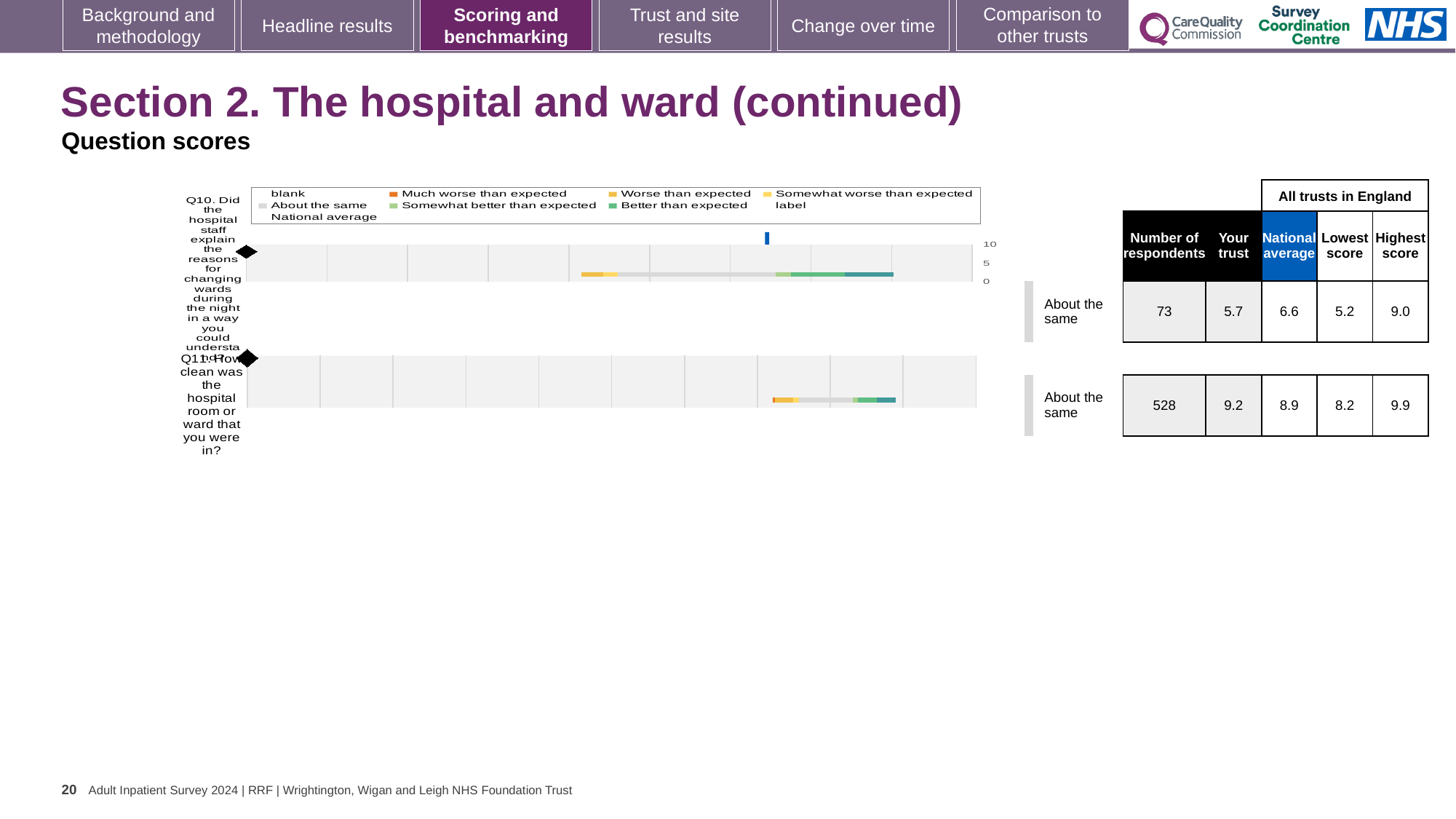
What benchmark category is shown for Q10? About the same What is the lowest score among all trusts in England for Q11? 8.2 How many survey questions are plotted on the slide? 2 What is the highest score among all trusts in England for Q10? 9.0 For Q10, which is larger: the trust's score or the national average? National average What is the national average score for Q11 (how clean was the hospital room or ward)? 8.9 For Q11, what is the difference between the trust's score and the national average? 0.3 What is the difference between the highest and lowest scores for Q10 across all trusts in England? 3.8 Which question has the higher 'Your trust' score, Q10 or Q11? Q11 What kind of chart is used to show the question scores for Q10 and Q11? Bar chart How many respondents answered Q11? 528 What is the 'Your trust' score for Q10 (explaining reasons for changing wards during the night)? 5.7